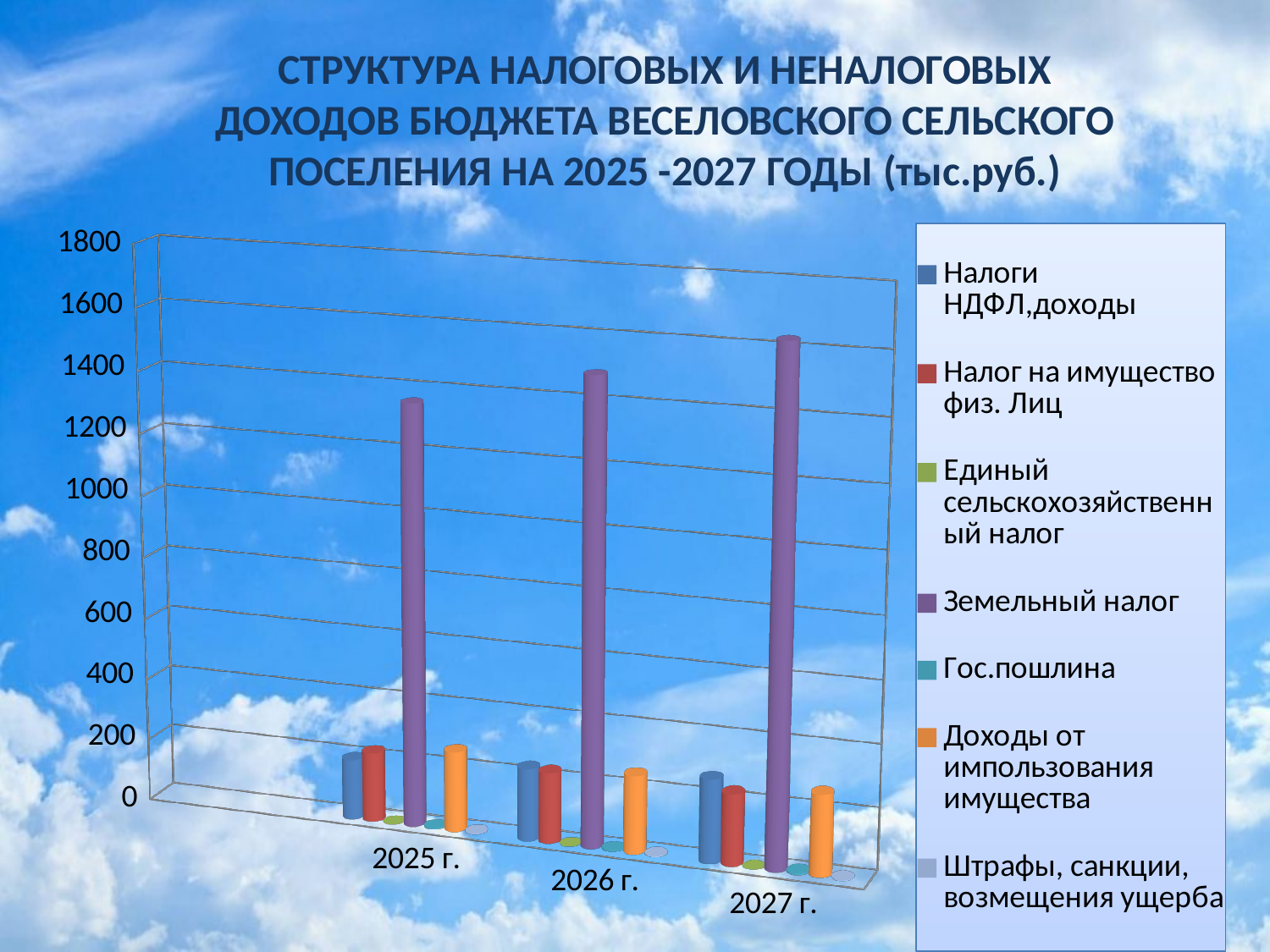
Does the value of Земельный налог rise or fall from 2025 г. to 2027 г.? Rises Which is larger in 2026 г.: Земельный налог or Налог на имущество физ. Лиц? Земельный налог How many year categories are shown on the x axis? 3 Is the value for Налоги НДФЛ,доходы in 2025 г. greater or less than 400? less How many series does the legend list? 7 Is the value for Земельный налог in 2025 г. greater or less than 1000? greater Is the value for Земельный налог in 2027 г. greater or less than 1200? greater Which series has the highest value in 2025 г.? Земельный налог Which is larger in 2025 г.: Доходы от импользования имущества or Единый сельскохозяйственный налог? Доходы от импользования имущества Which series has the highest value in 2027 г.? Земельный налог What colour represents Земельный налог in the legend? Purple What kind of chart is shown on the slide? Bar chart